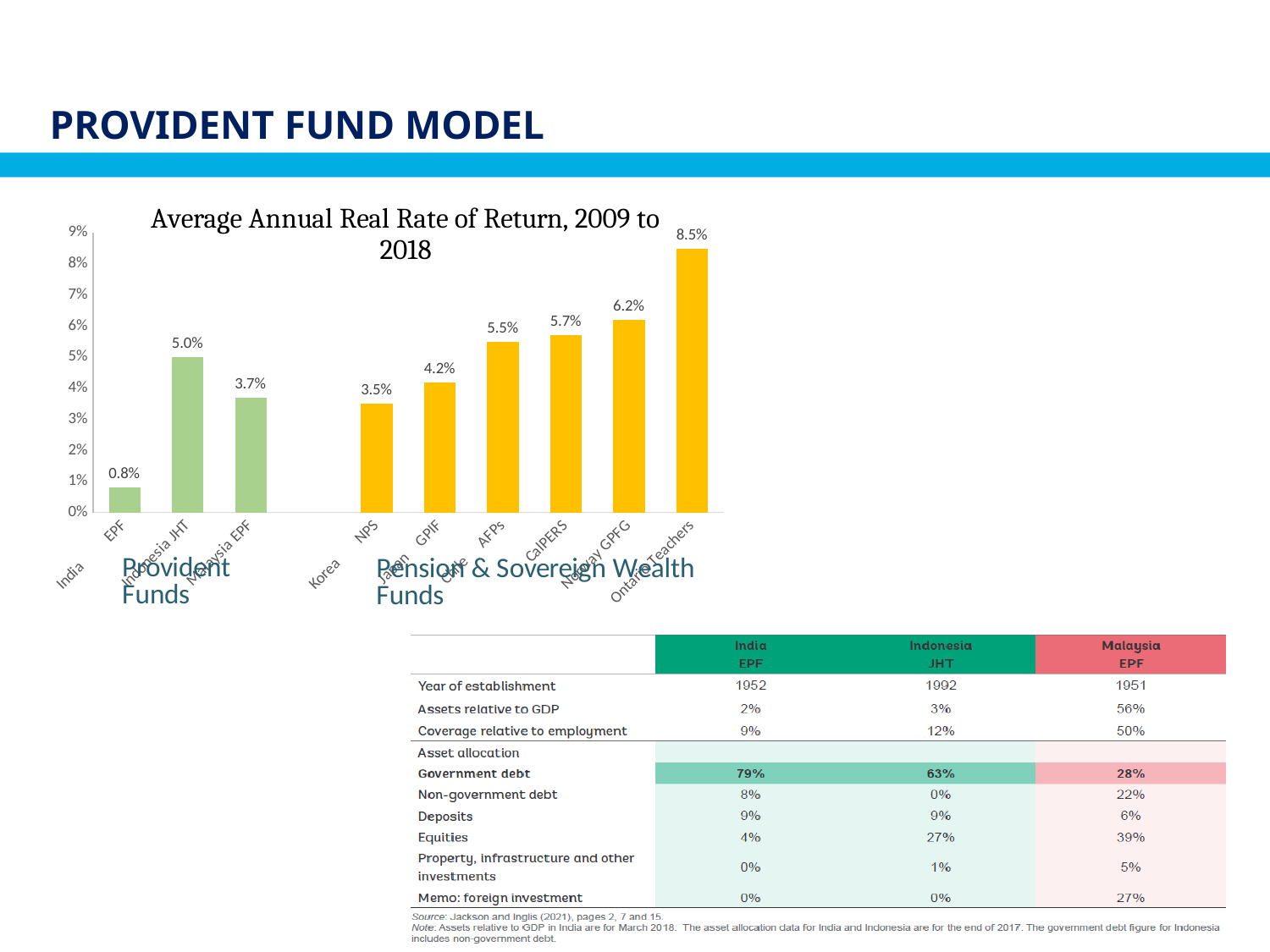
What is the value shown for CalPERS? 5.7% Which is larger, the value for Indonesia JHT or the value for Japan GPIF? Indonesia JHT Which category has the lowest average annual real rate of return? India EPF What is the difference between the values for Ontario Teachers and Korea NPS? 5.0% How many bars are plotted in the chart? 9 What is the value shown for Malaysia EPF? 3.7% Is the value for Norway GPFG greater or less than 6%? greater What kind of chart is shown on the slide? Bar chart What is the value shown for Indonesia JHT? 5.0% Which category has the highest average annual real rate of return? Ontario Teachers What is the average annual real rate of return shown for India EPF? 0.8% What is the title of the chart? Average Annual Real Rate of Return, 2009 to 2018